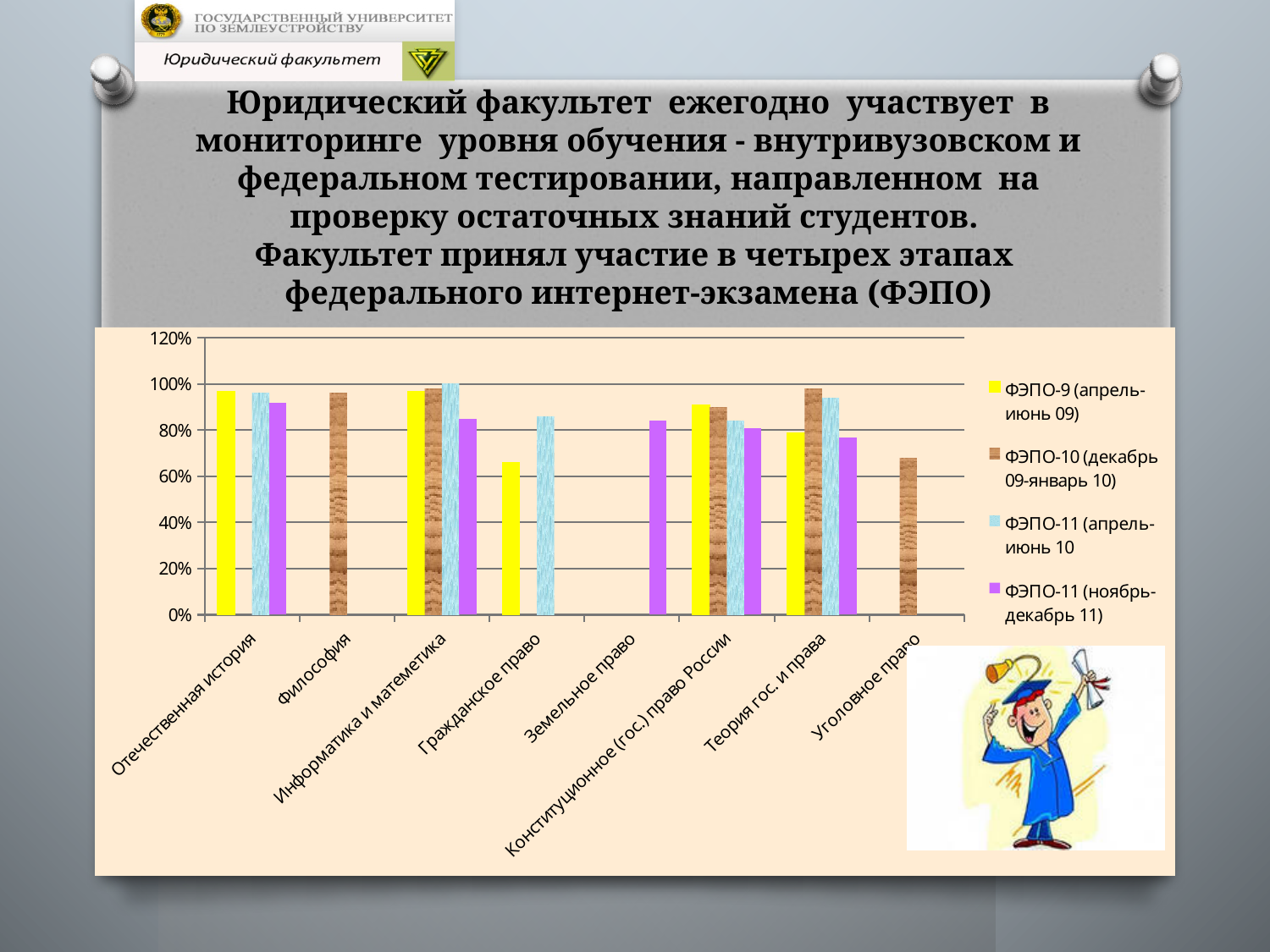
For Гражданское право, which series has the larger value: ФЭПО-9 (апрель-июнь 09) or ФЭПО-11 (апрель-июнь 10)? ФЭПО-11 (апрель-июнь 10) Is the value for Гражданское право in the ФЭПО-9 (апрель-июнь 09) series greater or less than 80%? less What is the highest value shown on the vertical axis of the chart? 120% How many categories are shown along the x axis of the chart? 8 Is the value for Философия in the ФЭПО-10 (декабрь 09-январь 10) series greater or less than 80%? greater How many series does the chart legend list? 4 Is the value for Гражданское право in the ФЭПО-9 (апрель-июнь 09) series greater or less than 60%? greater What colour are the bars for the ФЭПО-9 (апрель-июнь 09) series? yellow What kind of chart is shown on the slide? bar chart Which series is the only one with a bar for Уголовное право? ФЭПО-10 (декабрь 09-январь 10)